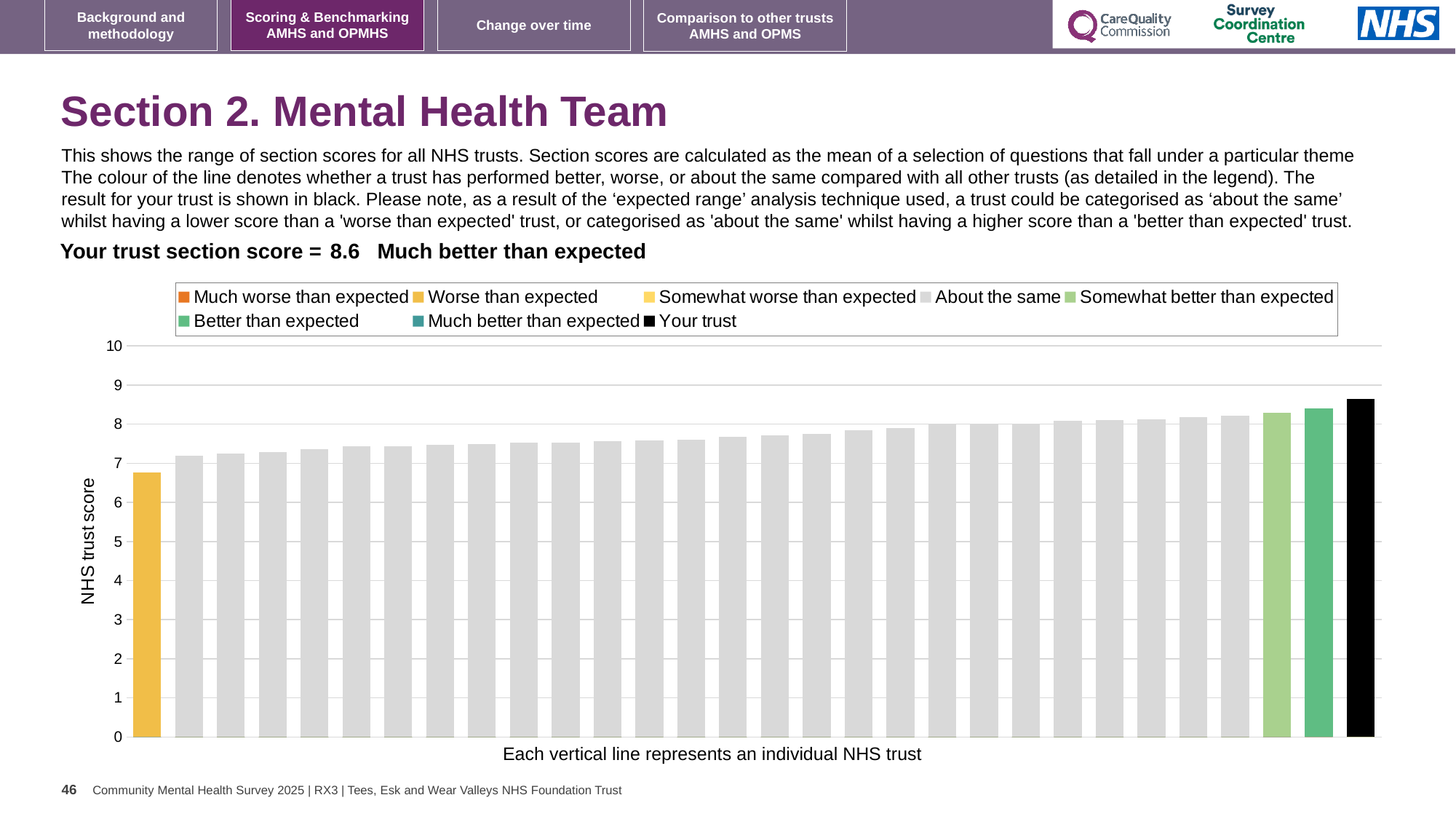
Is the value of the black 'Your trust' bar greater or less than 8? greater Which is larger: the black 'Your trust' bar or the yellow 'Worse than expected' bar? Your trust What is the label of the y axis? NHS trust score What is the section score for your trust shown on the slide? 8.6 Do the bar values rise or fall from left to right along the x axis? rise Which category does the lowest bar in the chart belong to? Worse than expected What colour is used for the 'Your trust' bar? black What kind of chart is shown on the slide? bar chart Which bar is the highest in the chart? Your trust (the black bar) How many entries does the chart legend list? 8 How many bars are coloured as 'Better than expected' (dark green)? 1 Is the value of the lowest (yellow) bar greater or less than 7? less